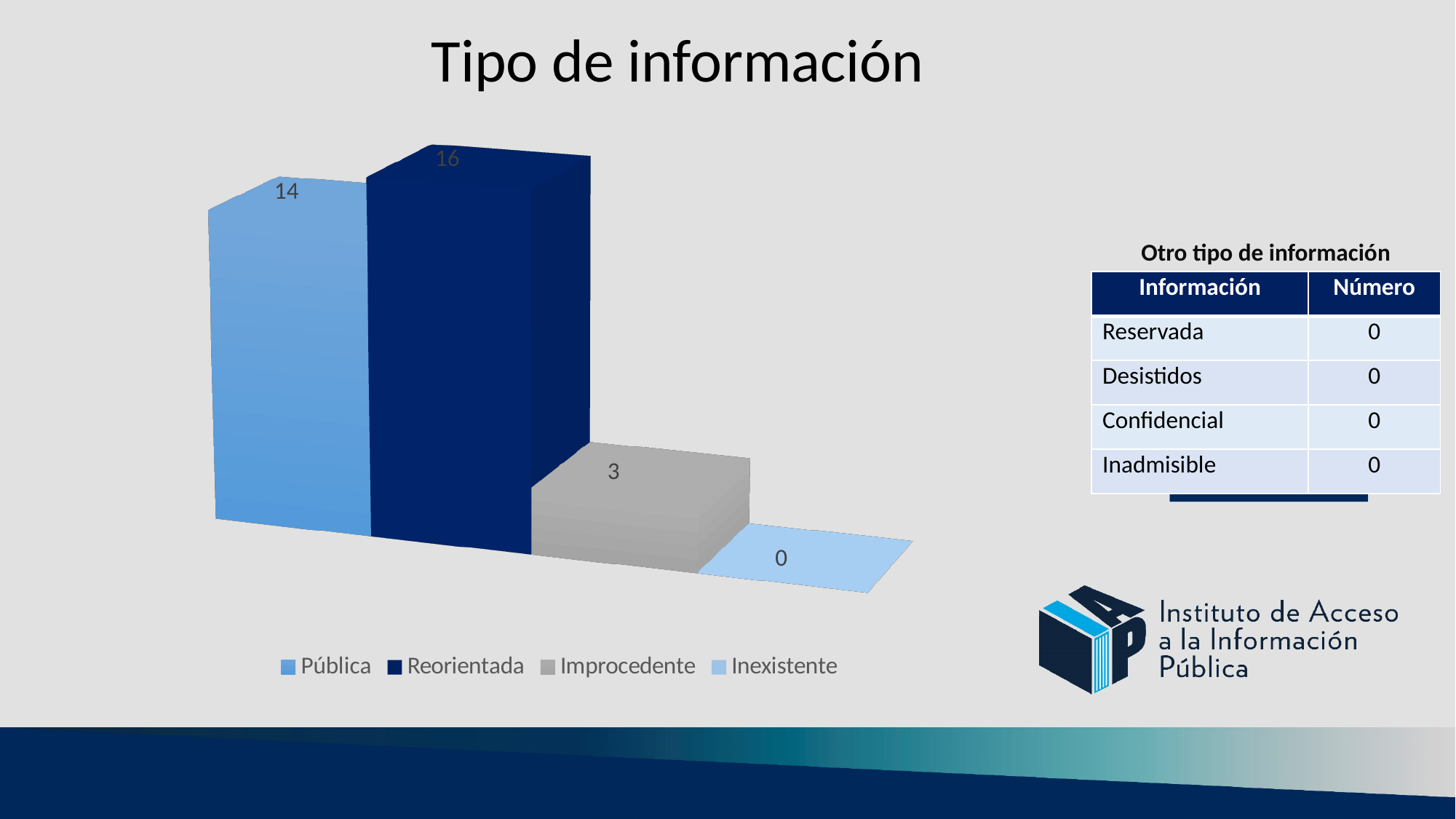
Which category has the highest value? Reorientada What kind of chart is shown on the slide? Bar chart What is the value for Pública? 14 What is the value for Reorientada? 16 What is the value for Inexistente? 0 What is the difference between the values for Reorientada and Pública? 2 How many categories are shown in the chart? 4 Which category has the lowest value? Inexistente What is the difference between the values for Pública and Improcedente? 11 Which is larger, the value for Pública or the value for Improcedente? Pública What is the value for Improcedente? 3 What is the title of the chart? Tipo de información